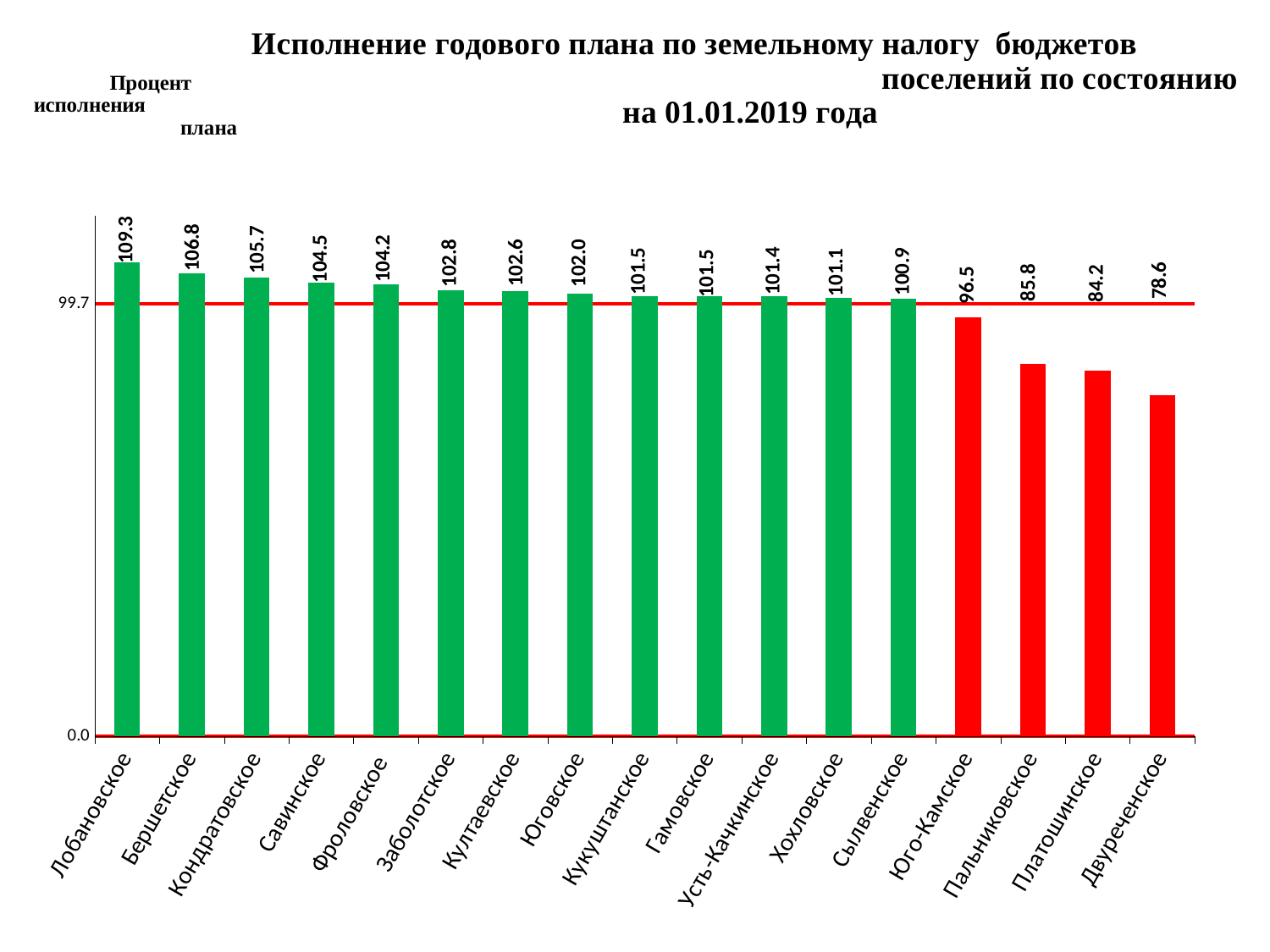
What value is marked by the horizontal red line on the chart? 99.7 What is the difference between the values for Лобановское and Двуреченское? 30.7 What is the difference between the values for Пальниковское and Платошинское? 1.6 What is the value for Юго-Камское? 96.5 Which is larger, the value for Бершетское or the value for Кондратовское? Бершетское Which category has the lowest value? Двуреченское What is the value for Лобановское? 109.3 What is the value for Сылвенское? 100.9 How many categories are shown on the x axis? 17 Do the values rise or fall from left to right along the x axis? Fall Which category has the highest value? Лобановское What kind of chart is shown on the slide? Bar chart